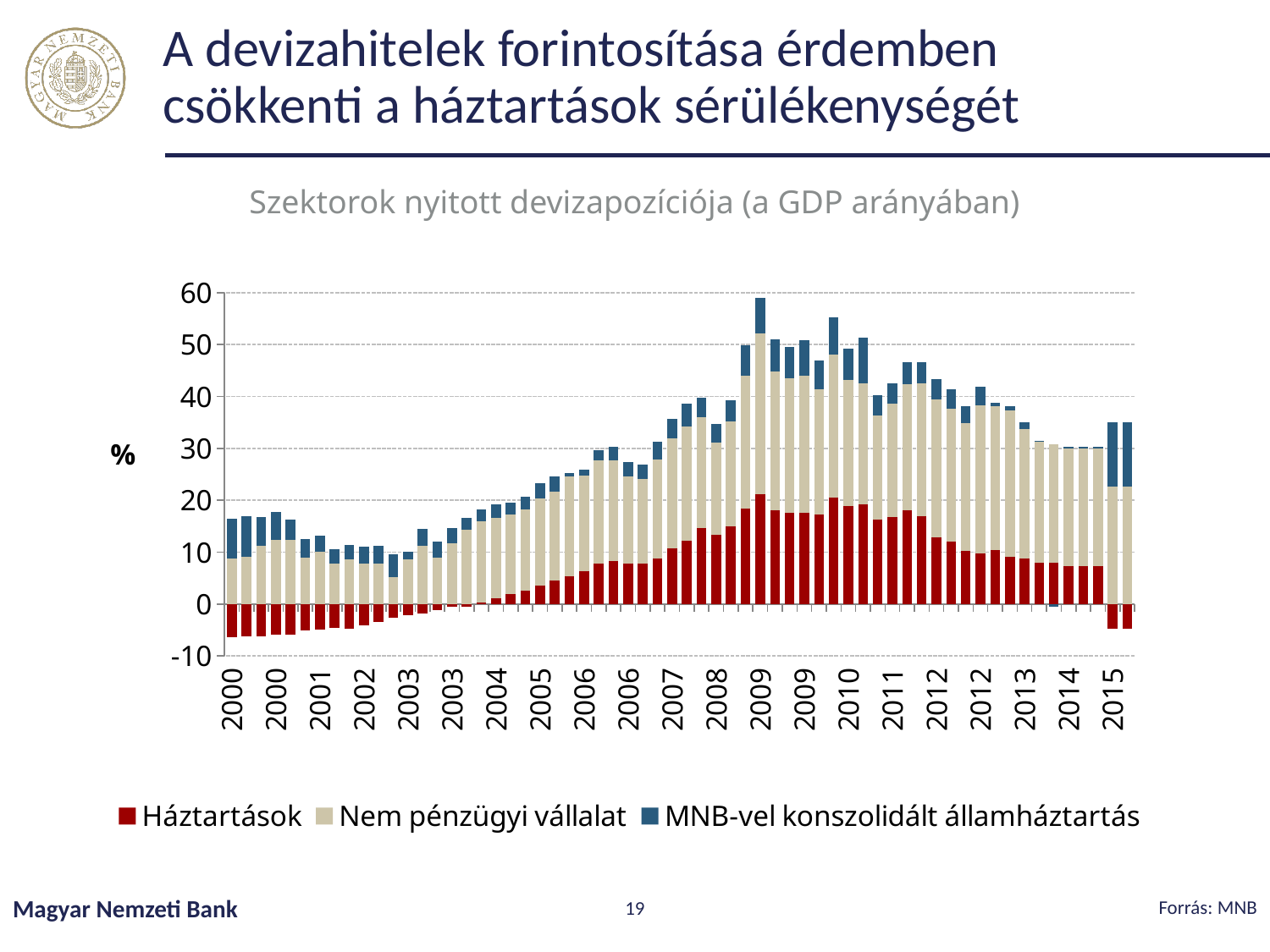
Does the Háztartások series rise or fall from 2000 to 2009? Rise What is the title of the chart? Szektorok nyitott devizapozíciója (a GDP arányában) Is the total height of the tallest stacked bar (first 2009 bar) greater or less than 50? greater Is the Háztartások value in the first 2000 bar greater or less than 0? less Which is larger, the Háztartások value in the first 2009 bar or in the first 2000 bar? 2009 Is the Háztartások value in the first 2009 bar greater or less than 10? greater Which colour represents the Háztartások series? Dark red Does the total stacked bar height rise or fall from 2009 to 2014? Fall How many series does the legend list? 3 What kind of chart is shown on the slide? Stacked bar chart Which year has the tallest stacked bar? 2009